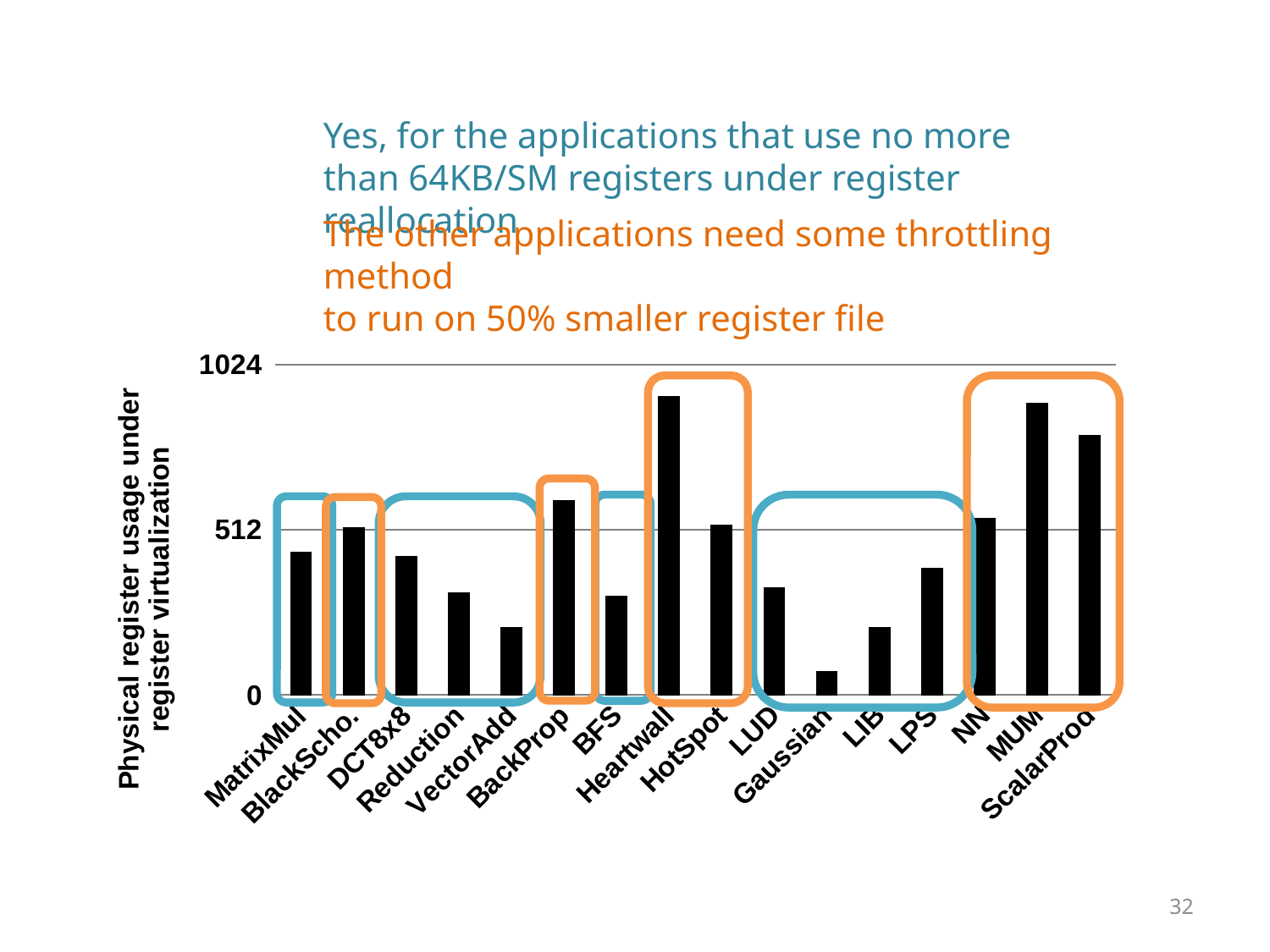
Is the value for BackProp greater or less than 512? greater Which has a higher physical register usage, ScalarProd or LUD? ScalarProd What is the label of the y axis of the chart? Physical register usage under register virtualization Is the value for Heartwall greater or less than 512? greater Which has a higher physical register usage, Heartwall or BFS? Heartwall Is the value for VectorAdd greater or less than 512? less What is the highest tick value shown on the y axis of the chart? 1024 Which application has the lowest physical register usage in the chart? Gaussian How many applications (categories) are plotted on the x axis of the chart? 16 What kind of chart is shown on the slide? bar chart